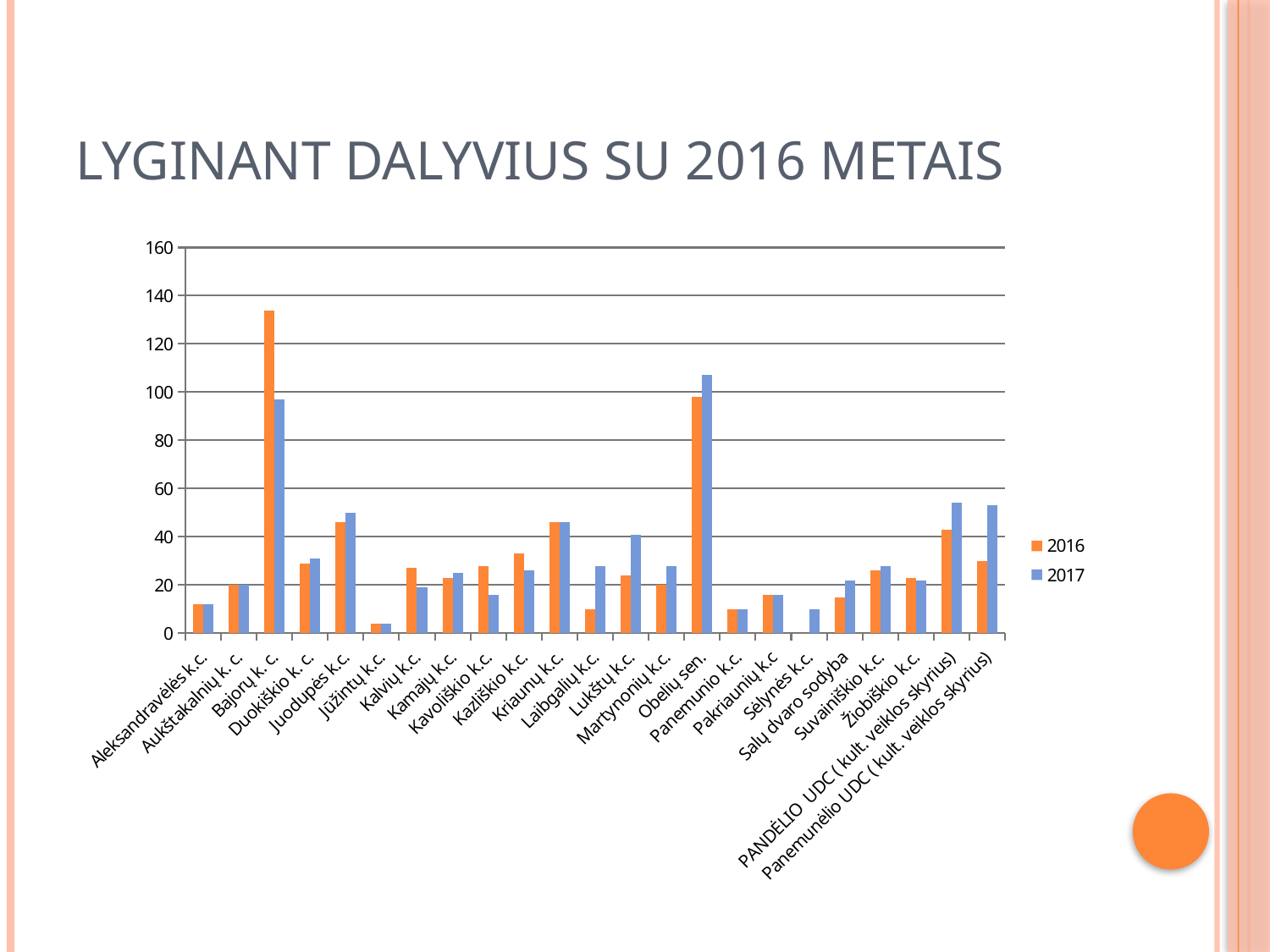
How many categories are shown on the x axis? 23 Which series are listed in the legend? 2016 and 2017 What kind of chart is shown on the slide? bar chart Is the 2017 value for Obelių sen. greater or less than 100? greater Is the 2017 value for Bajorų k. c. greater or less than 100? less For Bajorų k. c., which year has the larger value, 2016 or 2017? 2016 Which category has the highest value for 2016? Bajorų k. c. Which category has the highest value for 2017? Obelių sen. Is the 2016 value for Bajorų k. c. greater or less than 120? greater How many series does the legend list? 2 For Kavoliškio k.c., which year has the larger value, 2016 or 2017? 2016 For Lukštų k.c., which year has the larger value, 2016 or 2017? 2017